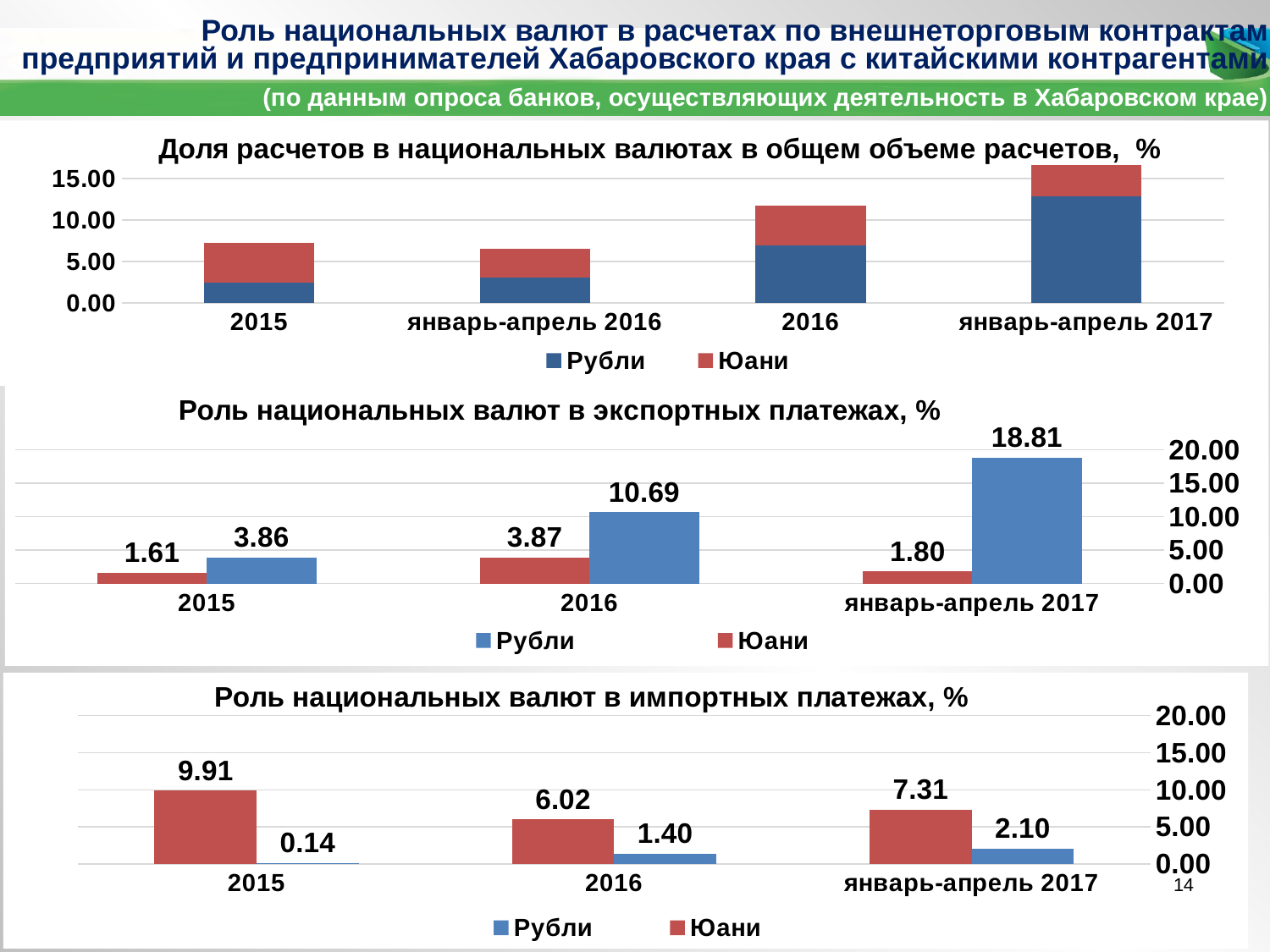
In the chart 'Роль национальных валют в экспортных платежах, %', which period has the highest value for Рубли? январь-апрель 2017 In the chart 'Роль национальных валют в экспортных платежах, %', what is the value for Рубли in 2016? 10.69 In the chart 'Роль национальных валют в импортных платежах, %', which period has the lowest value for Рубли? 2015 In the chart 'Роль национальных валют в импортных платежах, %', what is the value for Юани in 2015? 9.91 What type of chart is 'Роль национальных валют в экспортных платежах, %'? bar chart In the chart 'Роль национальных валют в экспортных платежах, %', what is the difference between the Рубли and Юани values in 2015? 2.25 In the chart 'Роль национальных валют в импортных платежах, %', what is the difference between the Юани values for 2015 and январь-апрель 2017? 2.60 In the chart 'Роль национальных валют в импортных платежах, %', do the Рубли values rise or fall from 2015 to январь-апрель 2017? rise In the chart 'Роль национальных валют в импортных платежах, %', which is larger in 2016: Рубли or Юани? Юани In the chart 'Роль национальных валют в экспортных платежах, %', what is the value for Юани in январь-апрель 2017? 1.80 In the top chart 'Доля расчетов в национальных валютах в общем объеме расчетов, %', is the total stacked value for январь-апрель 2017 greater or less than 15.00? greater How many categories are shown on the x axis of the top chart 'Доля расчетов в национальных валютах в общем объеме расчетов, %'? 4